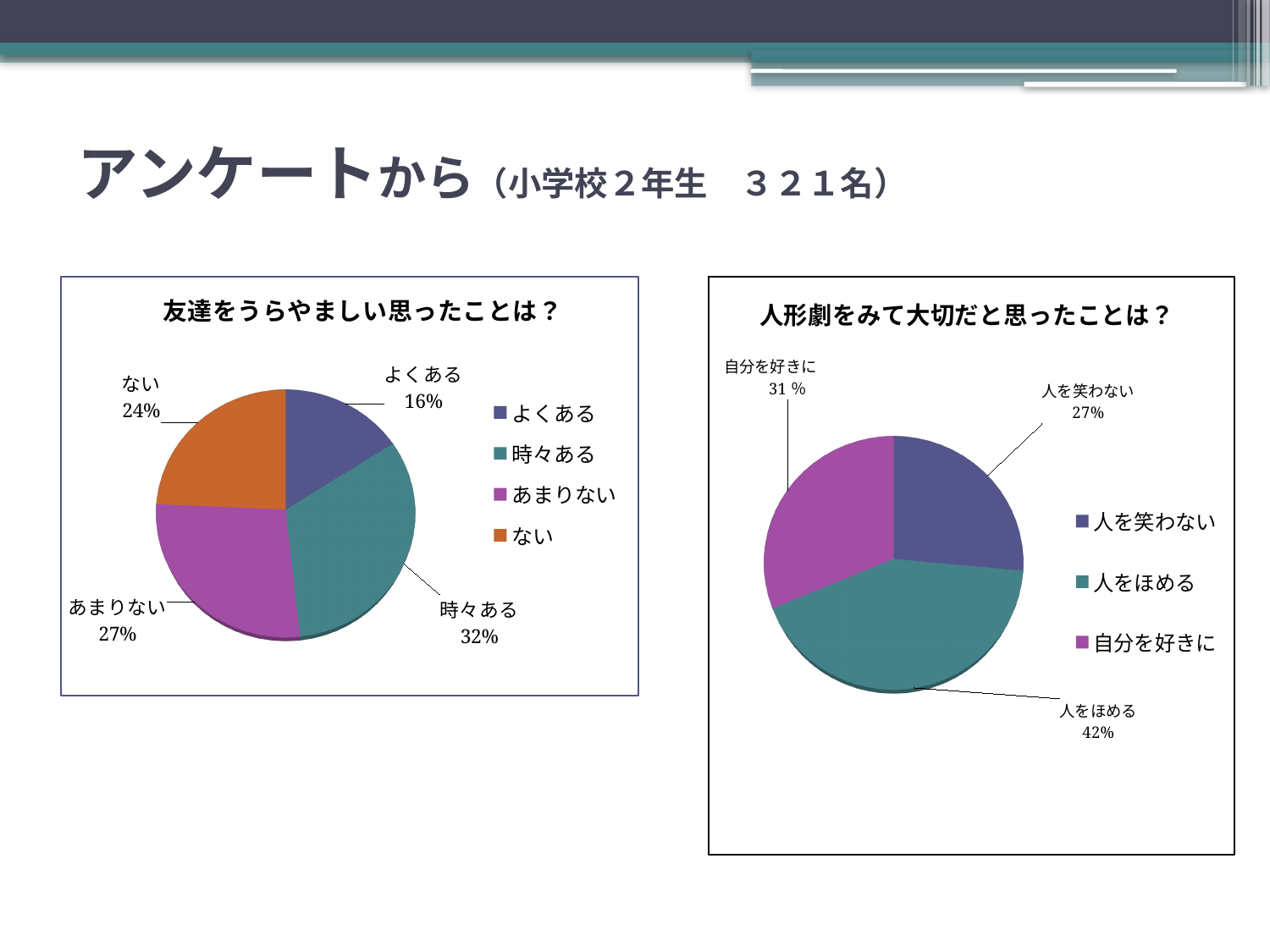
In the left chart titled 友達をうらやましい思ったことは？, which category has the smallest share? よくある In the right chart titled 人形劇をみて大切だと思ったことは？, which is larger, 人をほめる or 自分を好きに? 人をほめる In the left chart titled 友達をうらやましい思ったことは？, how many categories are shown? 4 In the left chart titled 友達をうらやましい思ったことは？, what percentage is shown for よくある? 16% In the left chart titled 友達をうらやましい思ったことは？, what is the difference in percentage points between あまりない and ない? 3 What type of chart is the left chart titled 友達をうらやましい思ったことは？? Pie chart In the right chart titled 人形劇をみて大切だと思ったことは？, how many categories does the legend list? 3 In the left chart titled 友達をうらやましい思ったことは？, which category has the largest share? 時々ある In the left chart titled 友達をうらやましい思ったことは？, what percentage is shown for 時々ある? 32% In the right chart titled 人形劇をみて大切だと思ったことは？, what percentage is shown for 自分を好きに? 31 % In the right chart titled 人形劇をみて大切だと思ったことは？, which category has the smallest share? 人を笑わない In the right chart titled 人形劇をみて大切だと思ったことは？, what percentage is shown for 人をほめる? 42%